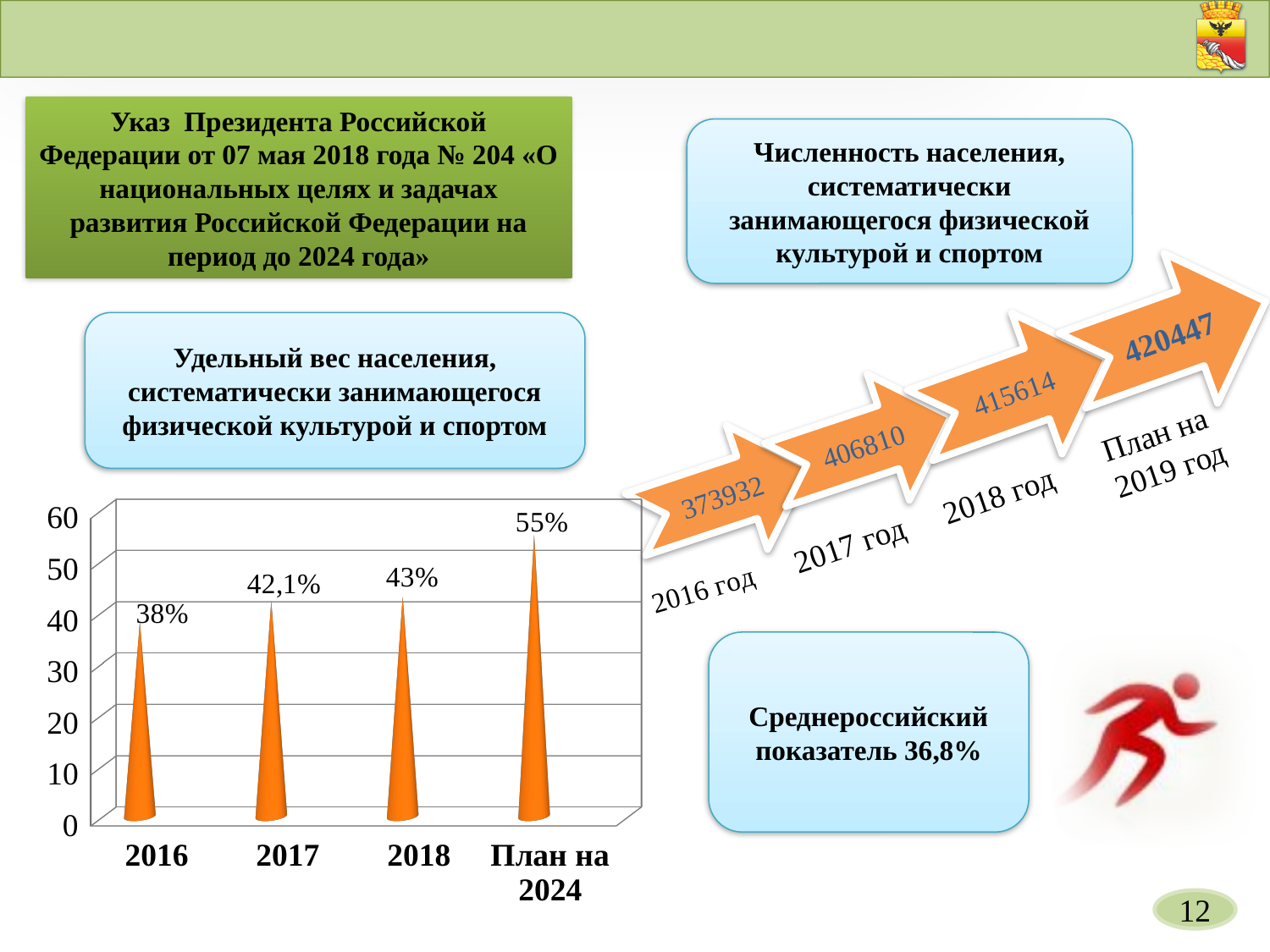
What is the difference between the value for План на 2024 and the value for 2016? 17% Which is larger, the value for 2017 or the value for 2018? 2018 What kind of chart is shown on the slide? bar chart Is the value for План на 2024 greater or less than 50? greater Do the values rise or fall from 2016 to План на 2024? rise What is the value for 2017 in the chart? 42,1% Which category has the highest value in the chart? План на 2024 What is the value for 2018 in the chart? 43% Which category has the lowest value in the chart? 2016 What is the value for План на 2024 in the chart? 55% What is the value for 2016 in the chart? 38% How many categories are shown on the x axis of the chart? 4